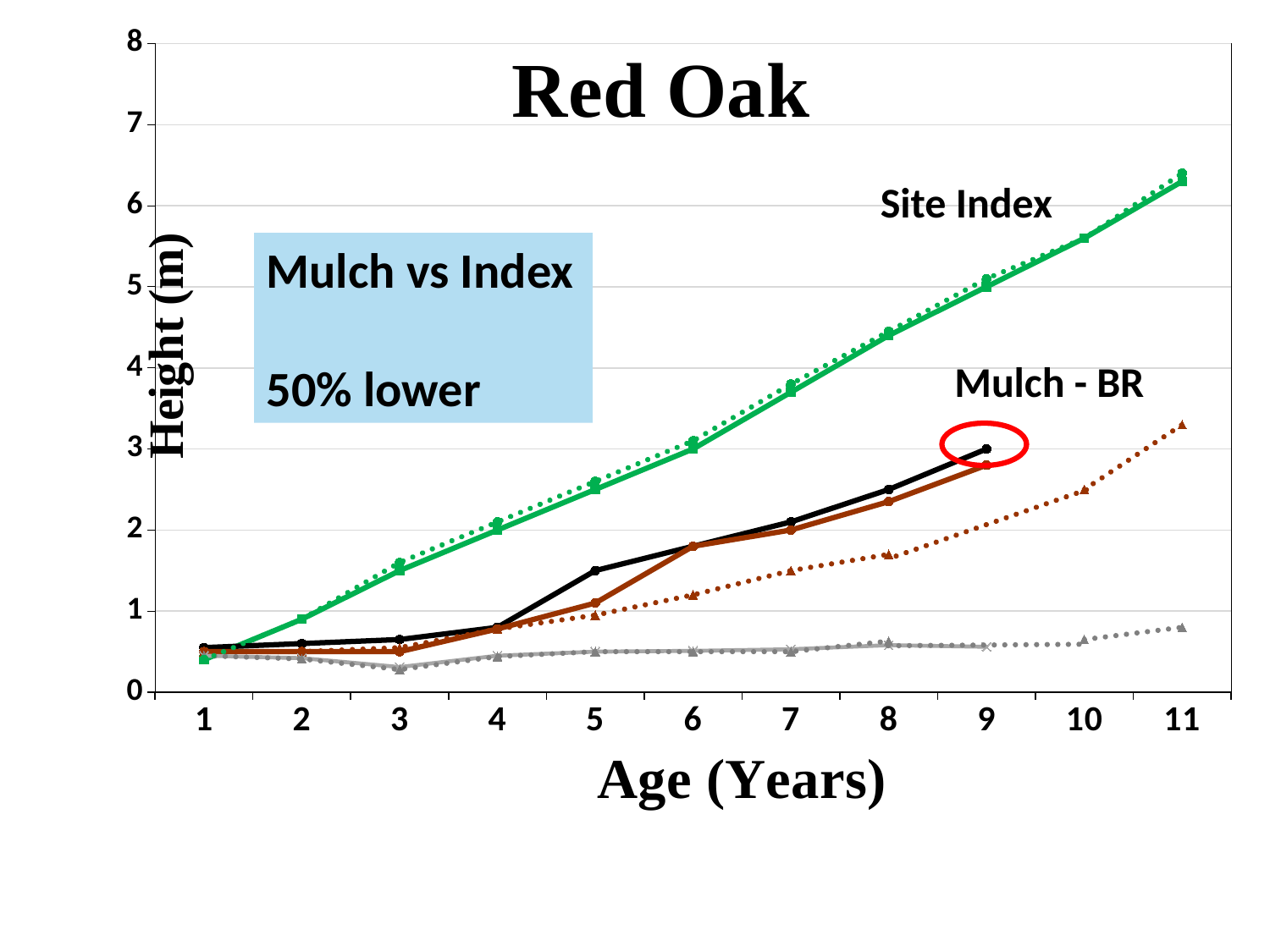
What is the label of the vertical axis? Height (m) Is the Site Index value at age 8 greater or less than 4? greater What is the highest value shown on the Height (m) axis? 8 How many age values are shown on the x axis? 11 Is the Site Index value at age 3 greater or less than 2? less What is the title of the chart? Red Oak What kind of chart is shown on the slide? line chart Is the Mulch - BR value at age 9 greater or less than 4? less At age 9, which is higher: Site Index or Mulch - BR? Site Index Does the Site Index line rise or fall as age increases? rises